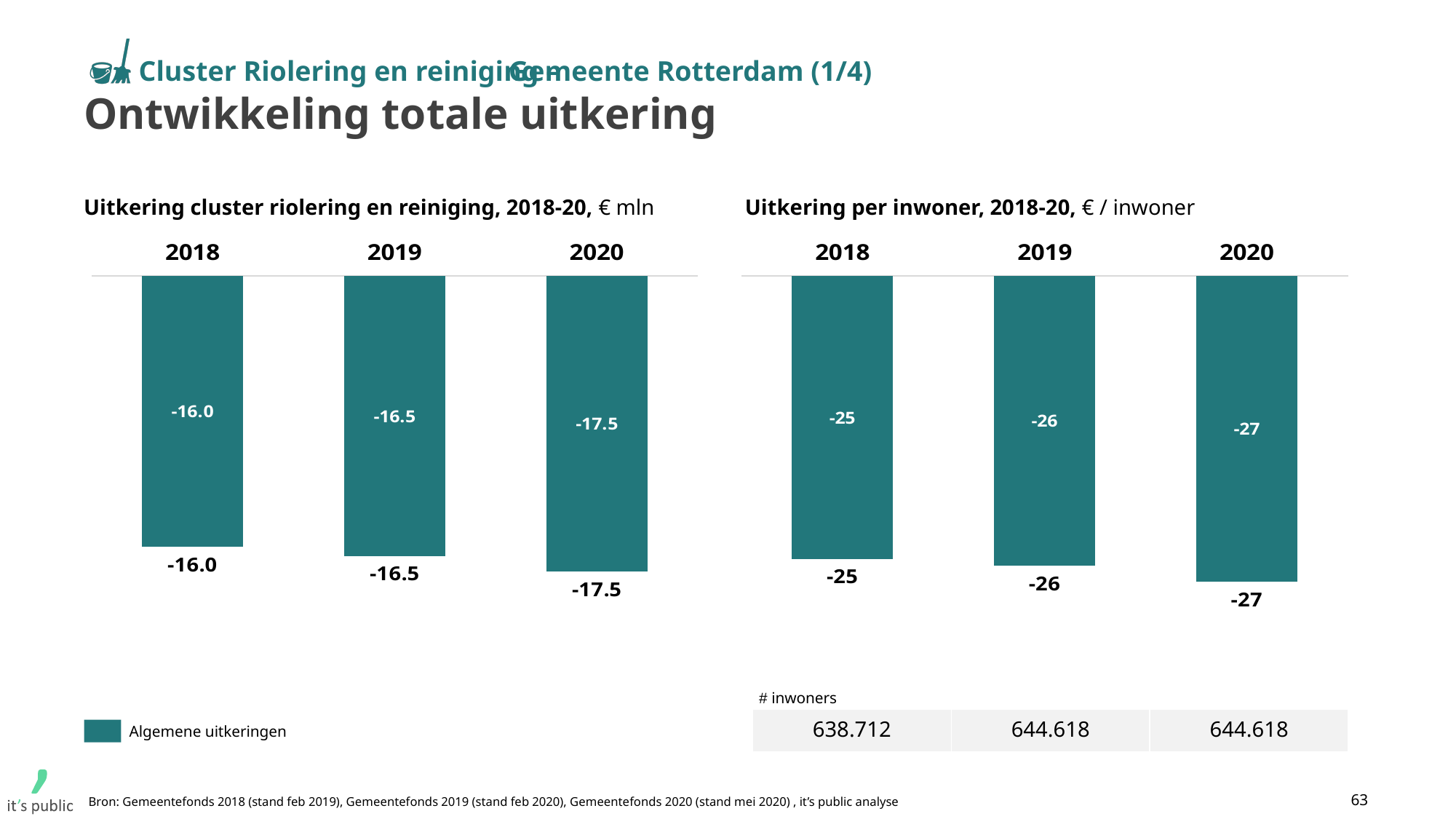
In the chart 'Uitkering per inwoner, 2018-20', what is the difference between the 2018 value and the 2020 value? 2 In the chart 'Uitkering cluster riolering en reiniging, 2018-20', what is the value for 2018? -16.0 In the chart 'Uitkering cluster riolering en reiniging, 2018-20', which year has the lowest (most negative) value? 2020 What series name does the legend on the slide list? Algemene uitkeringen In the chart 'Uitkering cluster riolering en reiniging, 2018-20', what is the difference between the 2018 value and the 2020 value? 1.5 In the chart 'Uitkering cluster riolering en reiniging, 2018-20', what is the value for 2020? -17.5 In the chart 'Uitkering per inwoner, 2018-20', what is the value for 2020? -27 In the chart 'Uitkering per inwoner, 2018-20', what is the value for 2019? -26 In the chart 'Uitkering cluster riolering en reiniging, 2018-20', do the values rise or fall from 2018 to 2020? Fall In the chart 'Uitkering per inwoner, 2018-20', which year has the highest (least negative) value? 2018 In the chart 'Uitkering cluster riolering en reiniging, 2018-20', how many years are shown? 3 What kind of chart is 'Uitkering per inwoner, 2018-20'? Bar chart